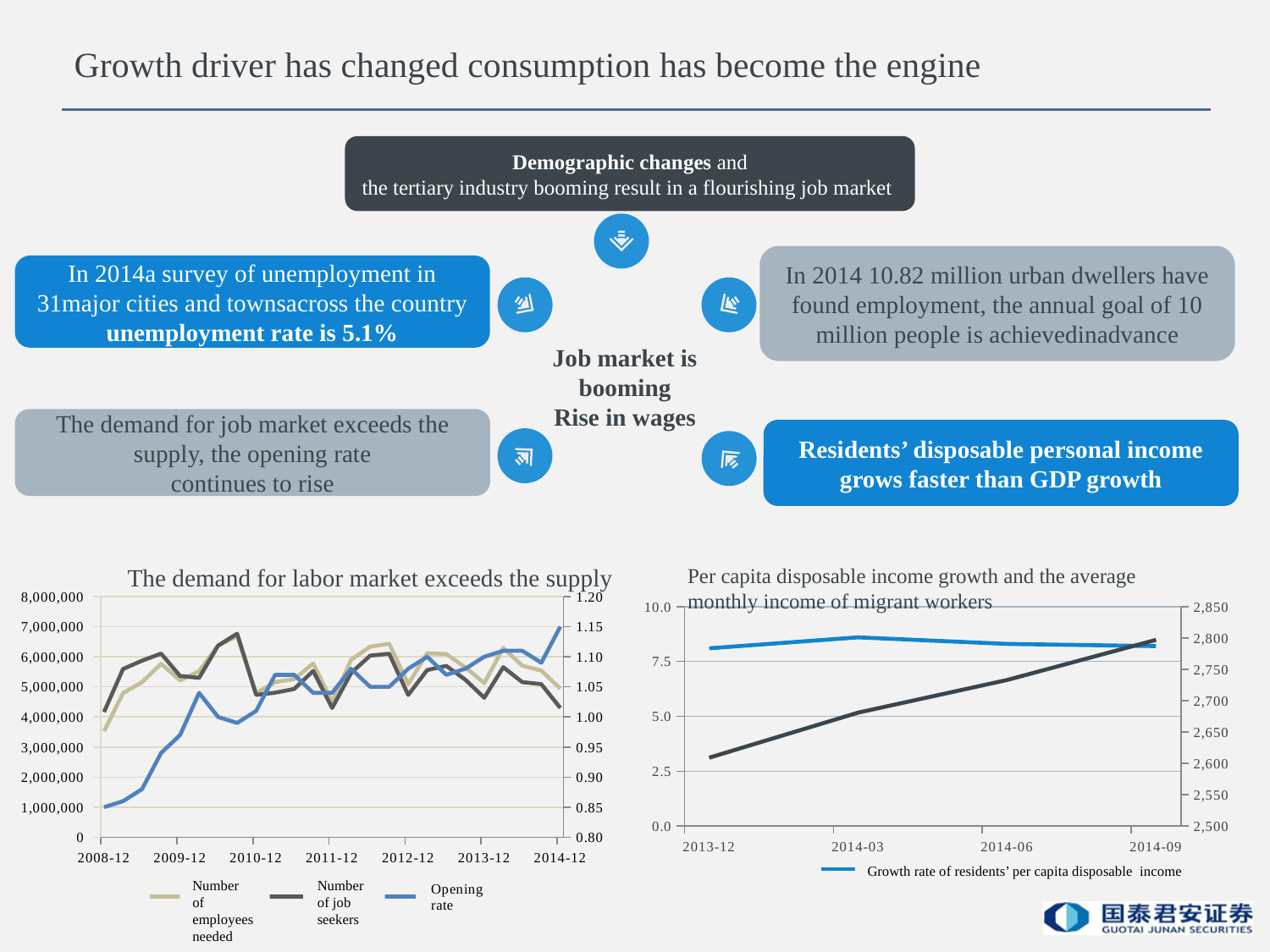
In 'The demand for labor market exceeds the supply', at which date is the Opening rate lowest? 2008-12 In 'Per capita disposable income growth and the average monthly income of migrant workers', is the Growth rate of residents' per capita disposable income at 2013-12 greater or less than 7.5? greater How many series does the legend of 'The demand for labor market exceeds the supply' list? 3 In 'The demand for labor market exceeds the supply', at which date is the Opening rate highest? 2014-12 In 'Per capita disposable income growth and the average monthly income of migrant workers', does the dark gray line rise or fall from 2013-12 to 2014-09? Rise How many date labels are shown on the x axis of 'Per capita disposable income growth and the average monthly income of migrant workers'? 4 In 'The demand for labor market exceeds the supply', is the Number of employees needed at 2008-12 greater or less than 4,000,000? less What kind of chart is 'Per capita disposable income growth and the average monthly income of migrant workers'? Line chart In 'The demand for labor market exceeds the supply', at 2014-12, which is larger: Number of employees needed or Number of job seekers? Number of employees needed What kind of chart is 'The demand for labor market exceeds the supply'? Line chart In 'The demand for labor market exceeds the supply', is the Opening rate at 2014-12 greater or less than 1.10? greater How many date labels are shown on the x axis of 'The demand for labor market exceeds the supply'? 7